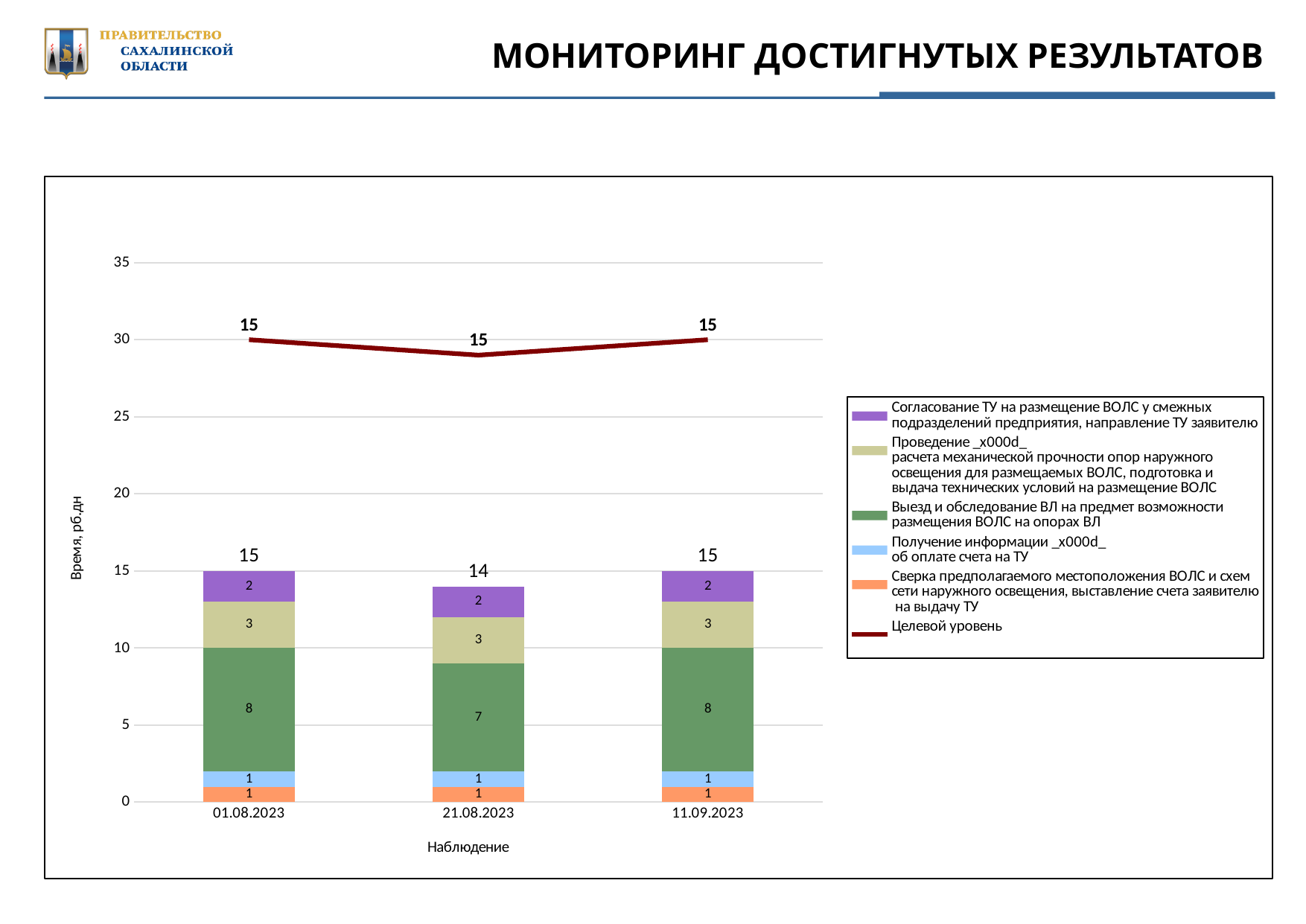
What is the label of the y axis? Время, рб.дн What is the total of the stacked bar for 21.08.2023? 14 Which observation date has the lowest stacked bar total? 21.08.2023 What is the value of the beige segment (Проведение расчета механической прочности опор наружного освещения...) for 11.09.2023? 3 How many observation dates are shown on the x axis? 3 What is the data label of the Целевой уровень line at 21.08.2023? 15 What is the total of the stacked bar for 01.08.2023? 15 What is the value of the purple segment (Согласование ТУ на размещение ВОЛС у смежных подразделений предприятия, направление ТУ заявителю) for 01.08.2023? 2 What is the difference between the stacked bar totals for 01.08.2023 and 21.08.2023? 1 What is the value of the green segment (Выезд и обследование ВЛ на предмет возможности размещения ВОЛС на опорах ВЛ) for 21.08.2023? 7 How many entries does the legend list? 6 What is the value of the green segment (Выезд и обследование ВЛ на предмет возможности размещения ВОЛС на опорах ВЛ) for 11.09.2023? 8